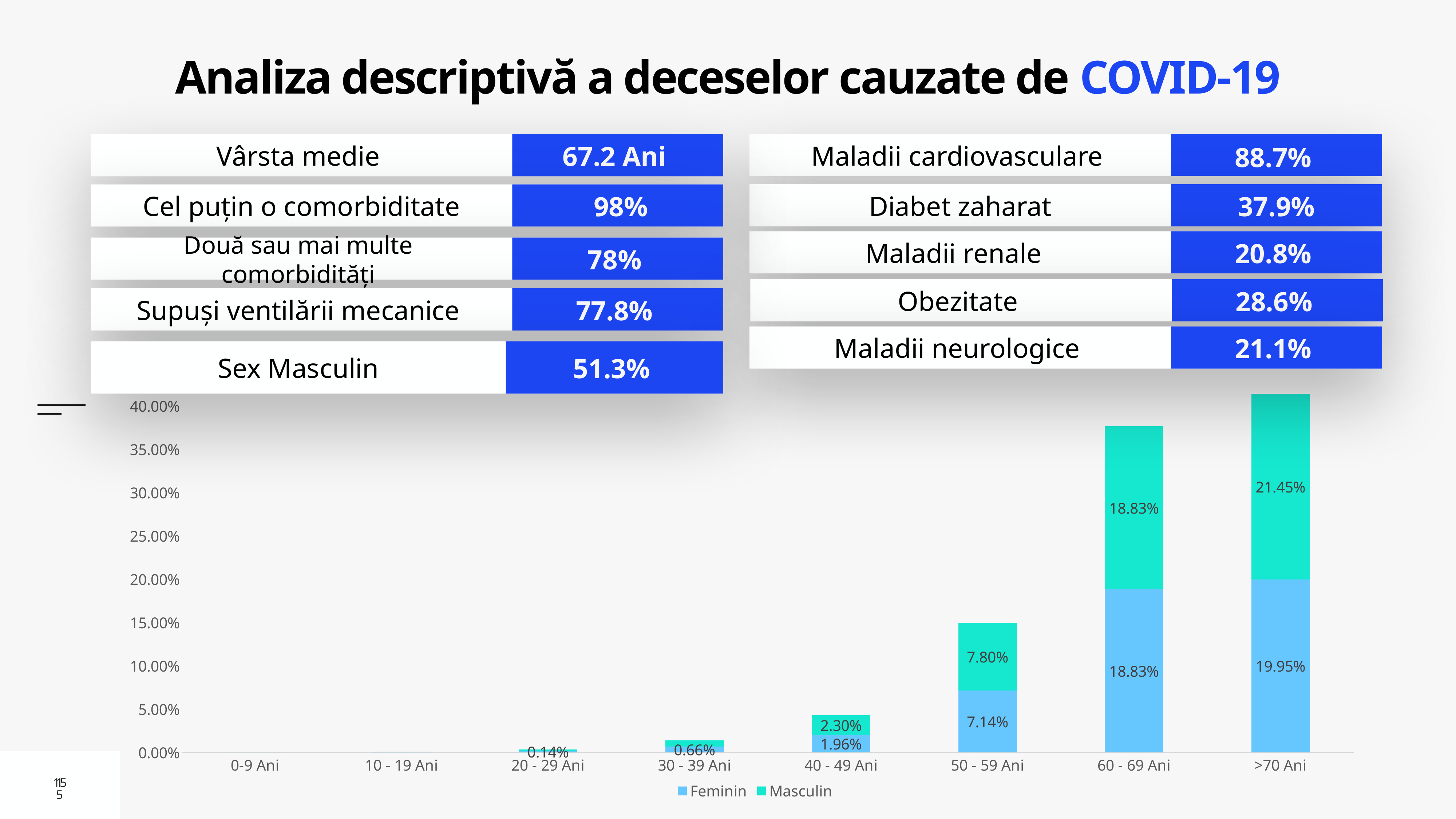
What is the Masculin value for the 50 - 59 Ani age group? 7.80% Is the total stacked value for the 60 - 69 Ani age group greater or less than 35.00%? greater What is the total of the stacked bar for the 40 - 49 Ani age group? 4.26% What kind of chart is shown at the bottom of the slide? Stacked bar chart For the 50 - 59 Ani age group, which is larger, the Feminin or the Masculin value? Masculin What is the Masculin value for the 60 - 69 Ani age group? 18.83% How many series does the chart legend list? 2 What is the Feminin value for the >70 Ani age group? 19.95% Which age group has the highest total stacked bar? >70 Ani What is the Feminin value for the 40 - 49 Ani age group? 1.96% How many age groups are shown on the x axis of the chart? 8 What is the difference between the Masculin and Feminin values for the >70 Ani age group? 1.50%